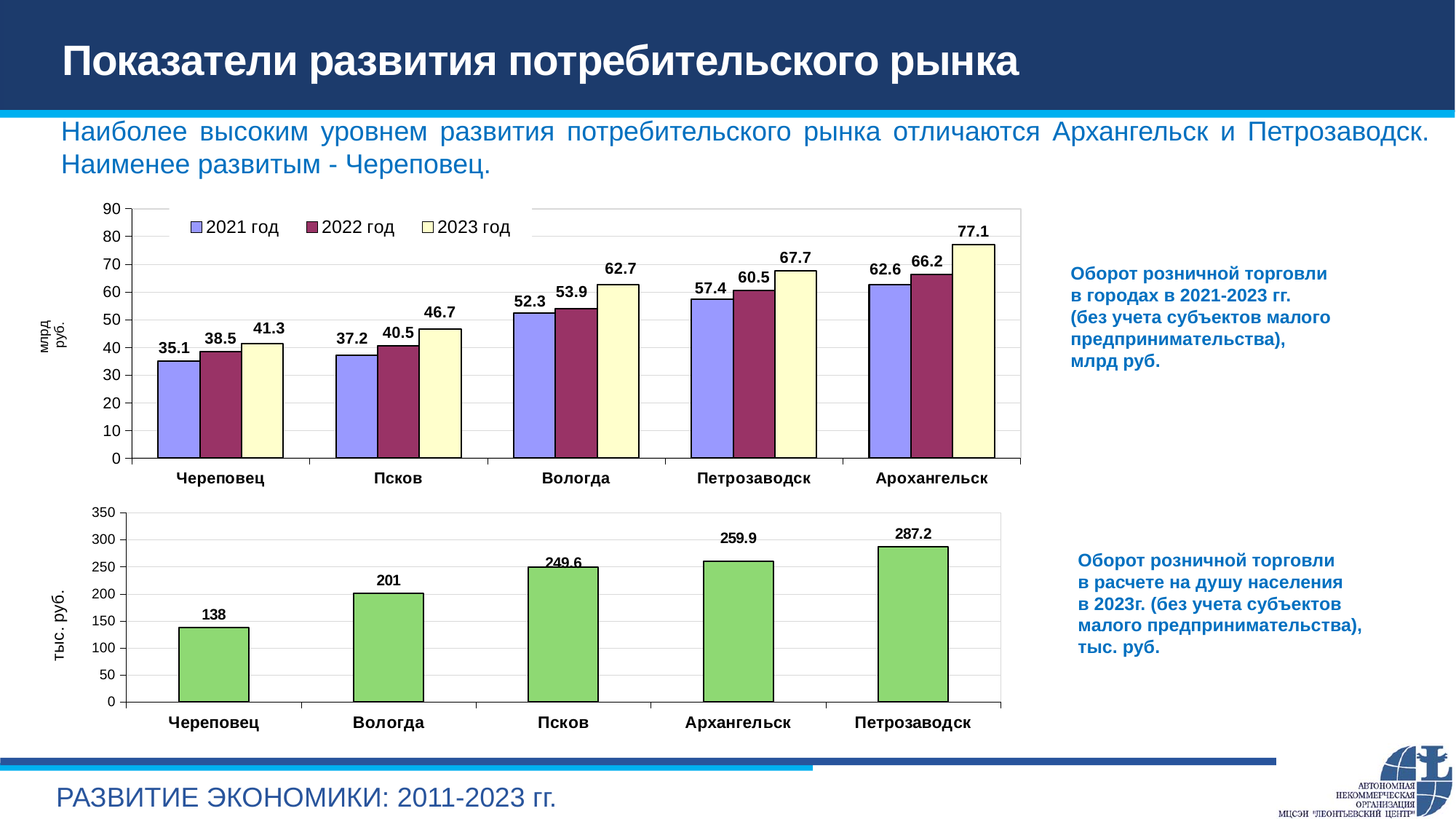
In the bottom chart (retail turnover per capita in 2023), how many cities are shown? 5 In the top chart (retail turnover in cities, 2021-2023), what is the value for Вологда in 2023? 62.7 In the top chart (retail turnover in cities, 2021-2023), what is the difference between the 2023 and 2021 values for Петрозаводск? 10.3 In the top chart (retail turnover in cities, 2021-2023), what is the value for Череповец in 2021? 35.1 In the top chart (retail turnover in cities, 2021-2023), which city has the highest value in 2023? Архангельск In the bottom chart (retail turnover per capita in 2023), which city has the highest value? Петрозаводск In the bottom chart (retail turnover per capita in 2023), what is the difference between Петрозаводск and Череповец? 149.2 What kind of chart is the bottom chart (retail turnover per capita in 2023)? bar chart In the bottom chart (retail turnover per capita in 2023), what is the value for Псков? 249.6 In the top chart (retail turnover in cities, 2021-2023), how many series does the legend list? 3 In the top chart (retail turnover in cities, 2021-2023), do the values for Псков rise or fall from 2021 to 2023? rise In the top chart (retail turnover in cities, 2021-2023), which city has the lowest value in 2022? Череповец